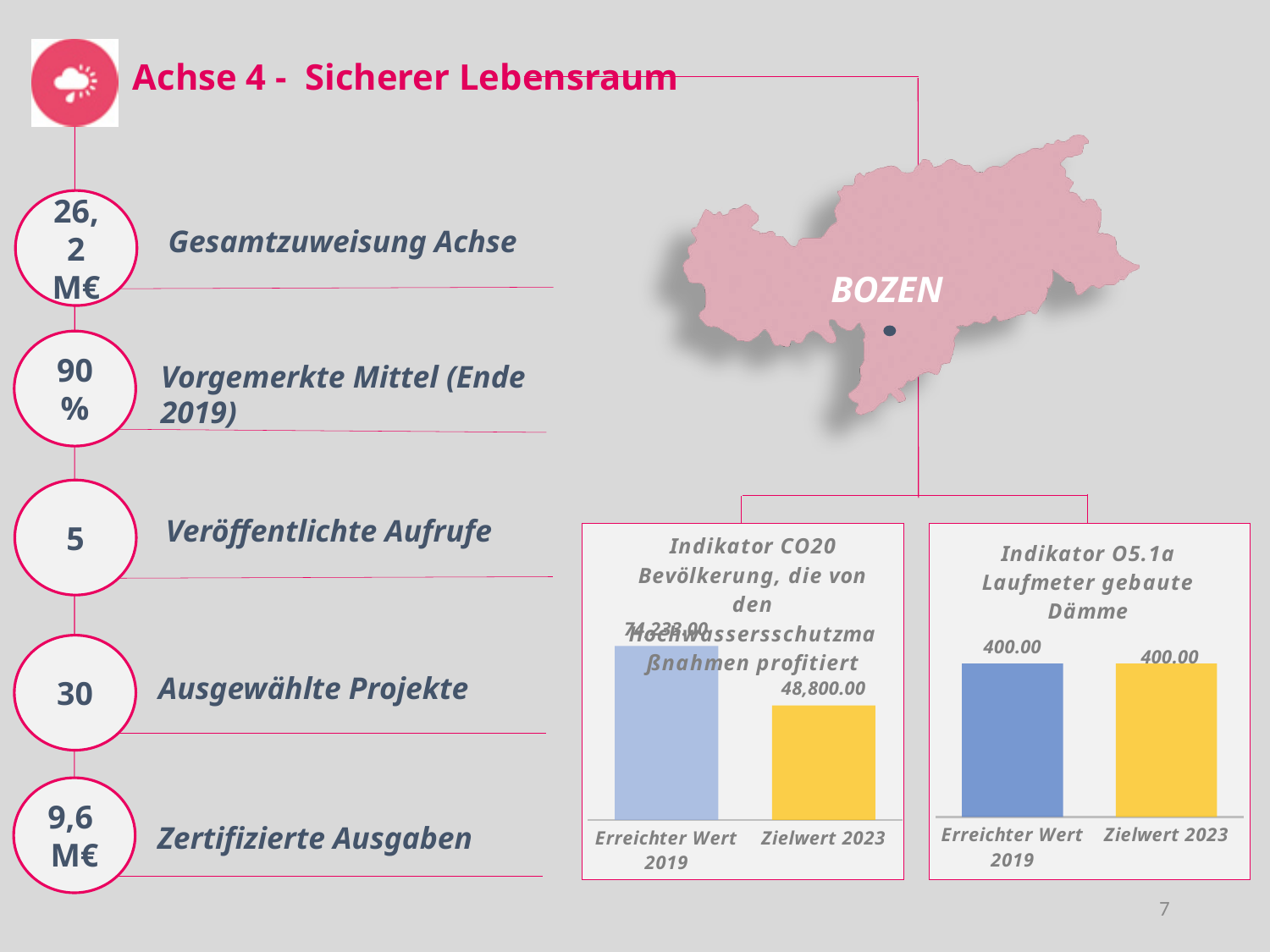
In the chart titled 'Indikator CO20', which category has the lowest value? Zielwert 2023 In the chart titled 'Indikator O5.1a Laufmeter gebaute Dämme', what is the value for Zielwert 2023? 400.00 In the chart titled 'Indikator O5.1a Laufmeter gebaute Dämme', what is the difference between the Zielwert 2023 and the Erreichter Wert 2019? 0.00 How many categories are shown in the chart titled 'Indikator CO20'? 2 What kind of chart is the chart titled 'Indikator O5.1a Laufmeter gebaute Dämme'? Bar chart How many charts are shown on the slide? 2 In the chart titled 'Indikator O5.1a Laufmeter gebaute Dämme', what is the value for Erreichter Wert 2019? 400.00 In the chart titled 'Indikator CO20', what is the value for Zielwert 2023? 48,800.00 In the chart titled 'Indikator CO20', do the values rise or fall from Erreichter Wert 2019 to Zielwert 2023? Fall In the chart titled 'Indikator O5.1a Laufmeter gebaute Dämme', what colour is the Zielwert 2023 bar? Yellow In the chart titled 'Indikator CO20', which category has the higher value, Erreichter Wert 2019 or Zielwert 2023? Erreichter Wert 2019 How many categories are shown in the chart titled 'Indikator O5.1a Laufmeter gebaute Dämme'? 2